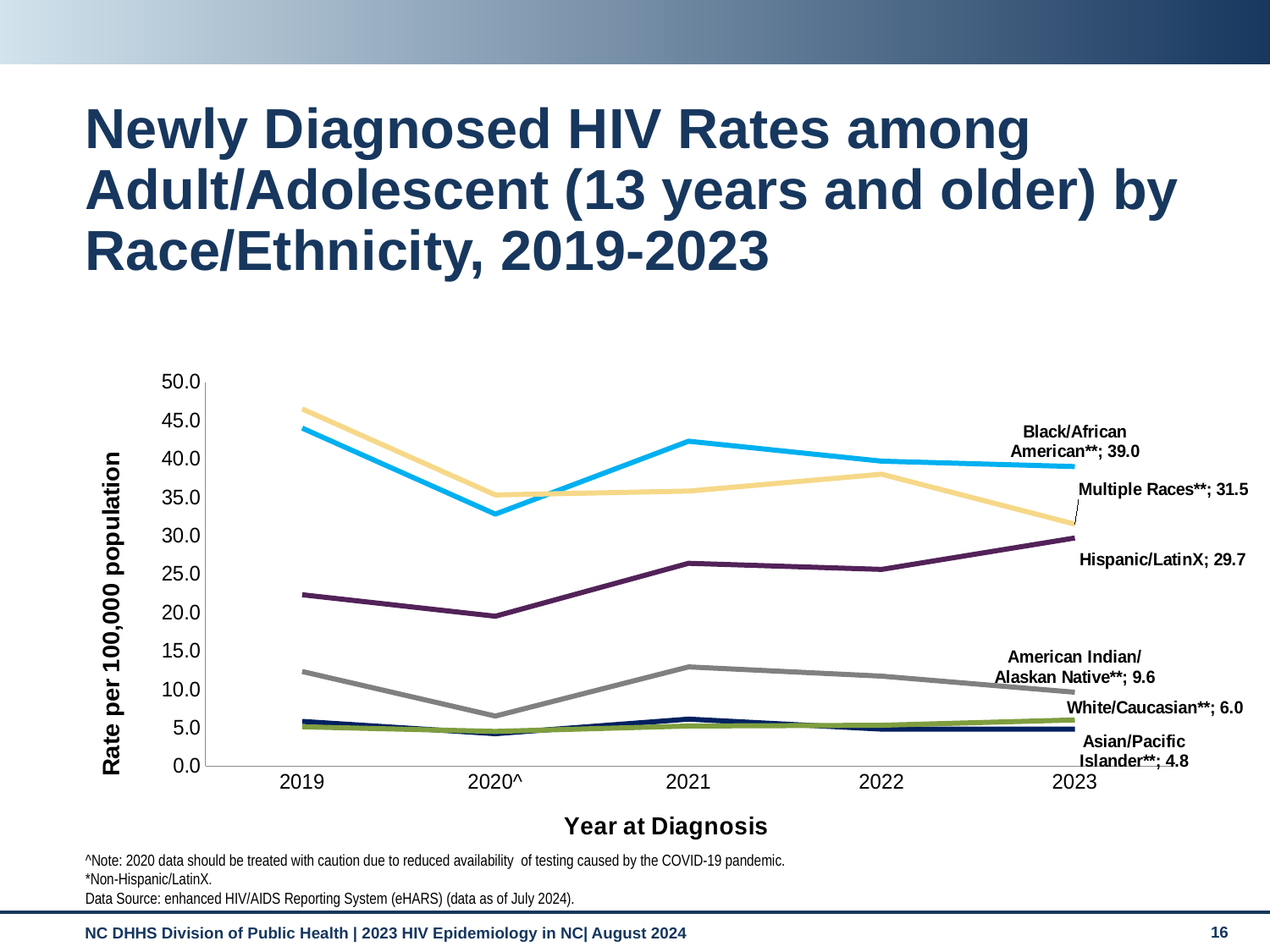
How many years are shown on the x axis? 5 Which race/ethnicity has the lowest rate in 2023? Asian/Pacific Islander What is the 2023 rate for Black/African American? 39.0 What is the 2023 rate for Asian/Pacific Islander? 4.8 What is the 2023 rate for Hispanic/LatinX? 29.7 Is the 2020 rate for Black/African American greater or less than 35.0? less Does the Hispanic/LatinX rate rise or fall from 2020 to 2023? rise Which race/ethnicity has the highest rate in 2023? Black/African American What is the difference between the 2023 rates for Black/African American and Multiple Races? 7.5 In 2023, which is larger: the rate for American Indian/Alaskan Native or the rate for White/Caucasian? American Indian/Alaskan Native Is the 2019 rate for Multiple Races greater or less than 40.0? greater What type of chart is shown on the slide? line chart